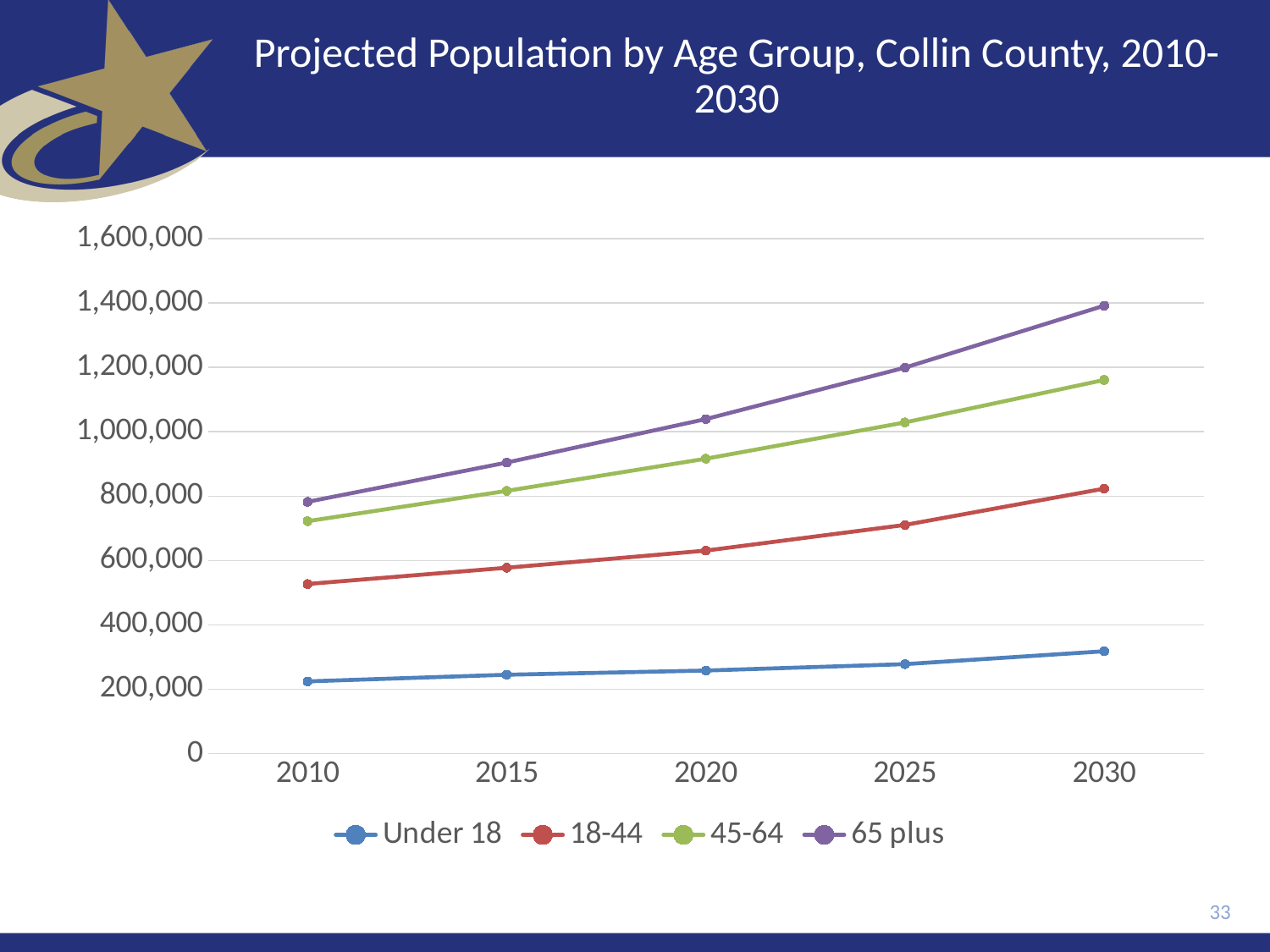
What kind of chart is shown on the slide? line chart What is the title of the chart? Projected Population by Age Group, Collin County, 2010-2030 How many years are plotted along the x axis? 5 Do the values for 65 plus rise or fall from 2010 to 2030? rise Is the value for Under 18 in 2030 greater or less than 400,000? less How many series does the legend list? 4 Is the value for 45-64 in 2010 greater or less than 800,000? less